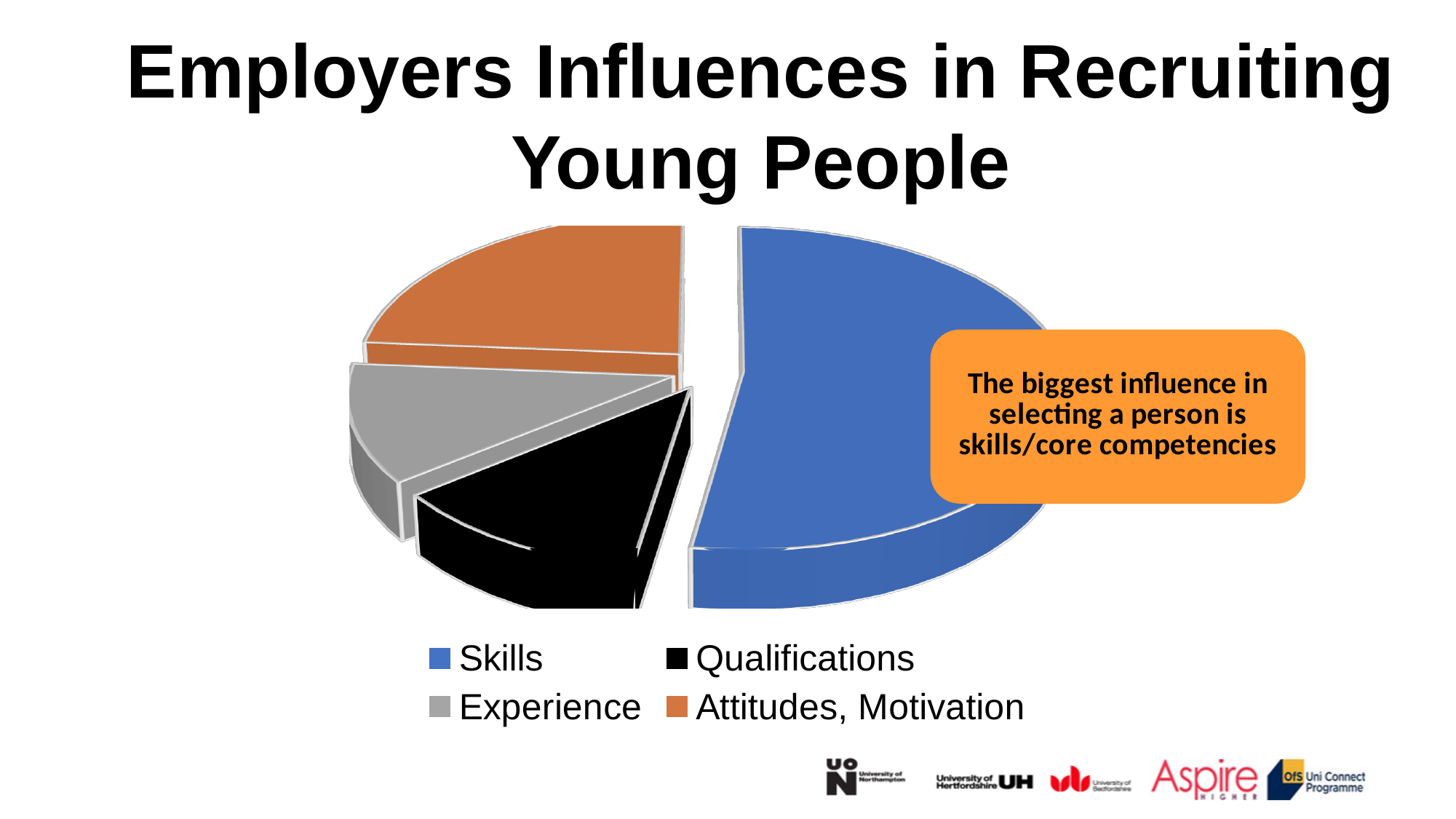
How many slices does the pie chart have? 4 Which category is shown in orange in the legend? Attitudes, Motivation What kind of chart is shown on the slide? Pie chart Which is larger, the slice for Skills or the slice for Qualifications? Skills Which is larger, the slice for Skills or the slice for Attitudes, Motivation? Skills What colour is the Skills slice? Blue Which is larger, the slice for Skills or the slice for Experience? Skills Which category has the largest slice of the pie? Skills How many entries does the legend list? 4